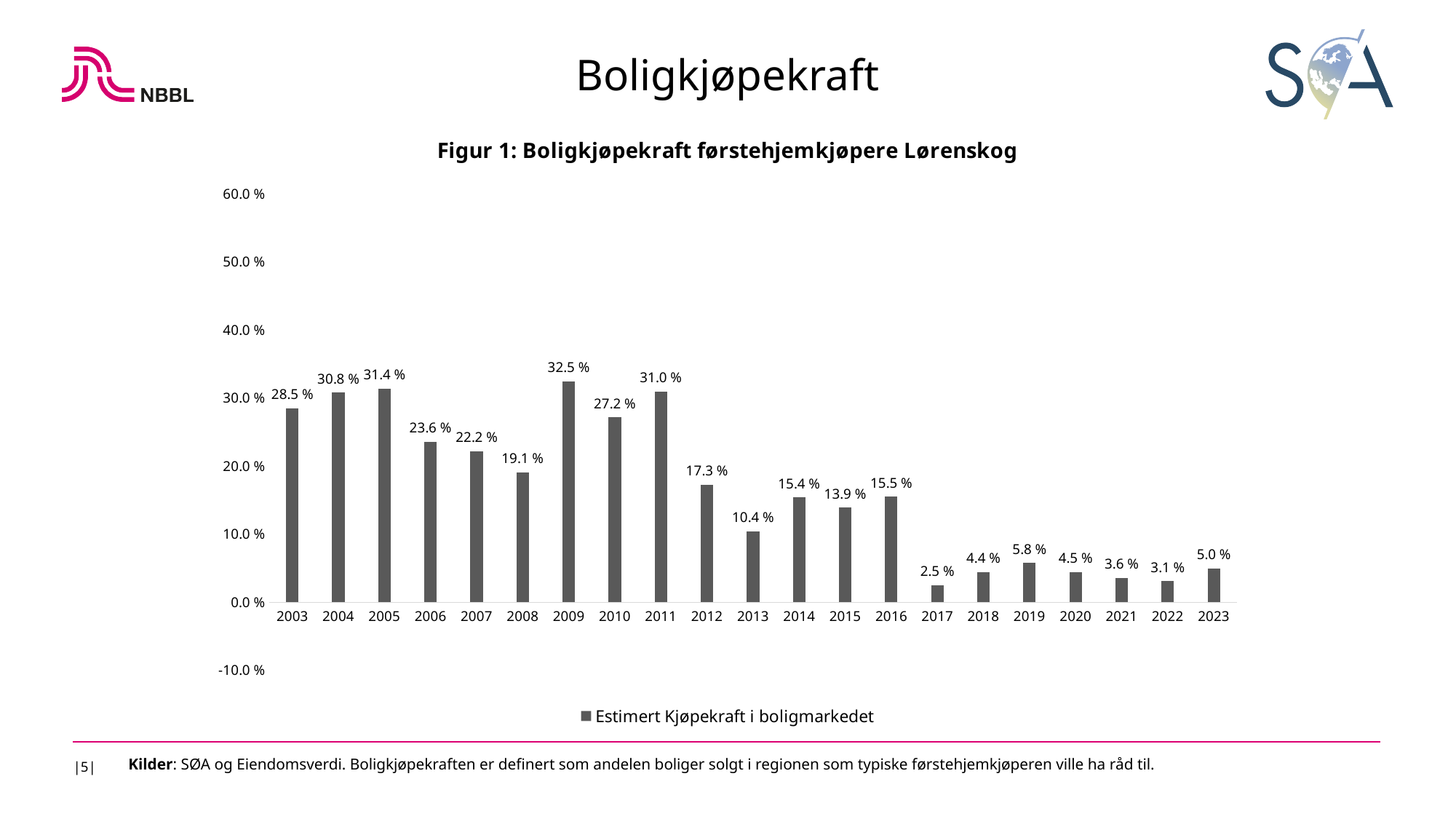
Is the value for 2013 greater or less than 20.0 %? less What kind of chart is shown? bar chart What is the value for 2009? 32.5 % Which year has the lowest value? 2017 Which year has the highest value? 2009 Which is larger, the value for 2011 or the value for 2010? 2011 What is the value for 2023? 5.0 % What is the legend entry for the series? Estimert Kjøpekraft i boligmarkedet What is the value for 2017? 2.5 % How many years are shown on the x axis? 21 What is the difference between the values for 2003 and 2023? 23.5 % How many series does the legend list? 1